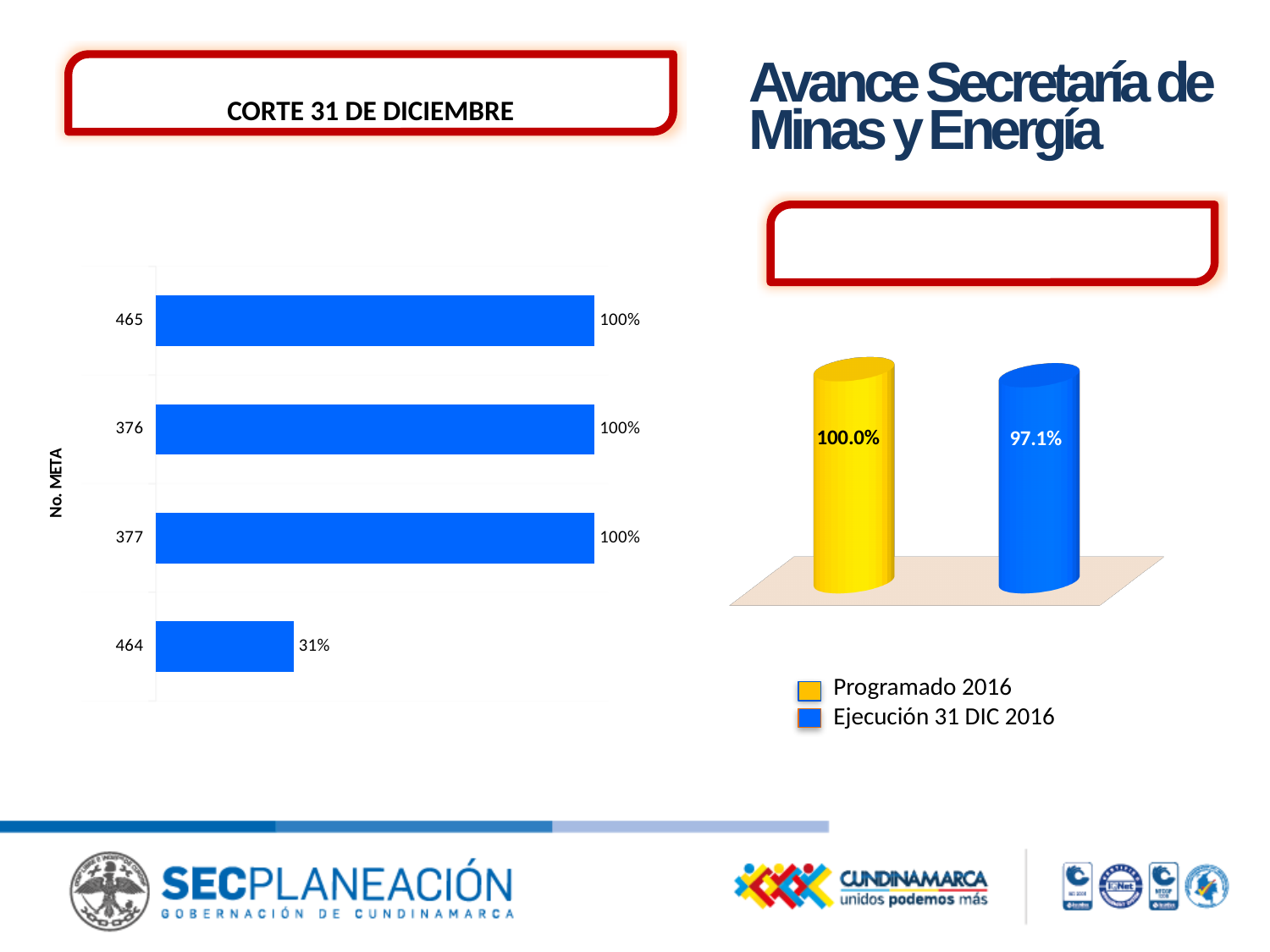
In the left bar chart, which is larger, the value for meta 376 or meta 464? 376 In the left bar chart, what is the value for meta 465? 100% In the right chart, what is the value for Ejecución 31 DIC 2016? 97.1% In the left bar chart, what is the value for meta 464? 31% What kind of chart is the chart on the left? bar chart In the left bar chart, how many metas are plotted? 4 In the left bar chart, what is the difference between the values for meta 377 and meta 464? 69% In the right chart, what is the value for Programado 2016? 100.0% In the left bar chart, which meta has the lowest value? 464 How many series does the legend of the right chart list? 2 In the right chart, what is the difference between Programado 2016 and Ejecución 31 DIC 2016? 2.9% In the left bar chart, what is the label of the vertical axis? No. META